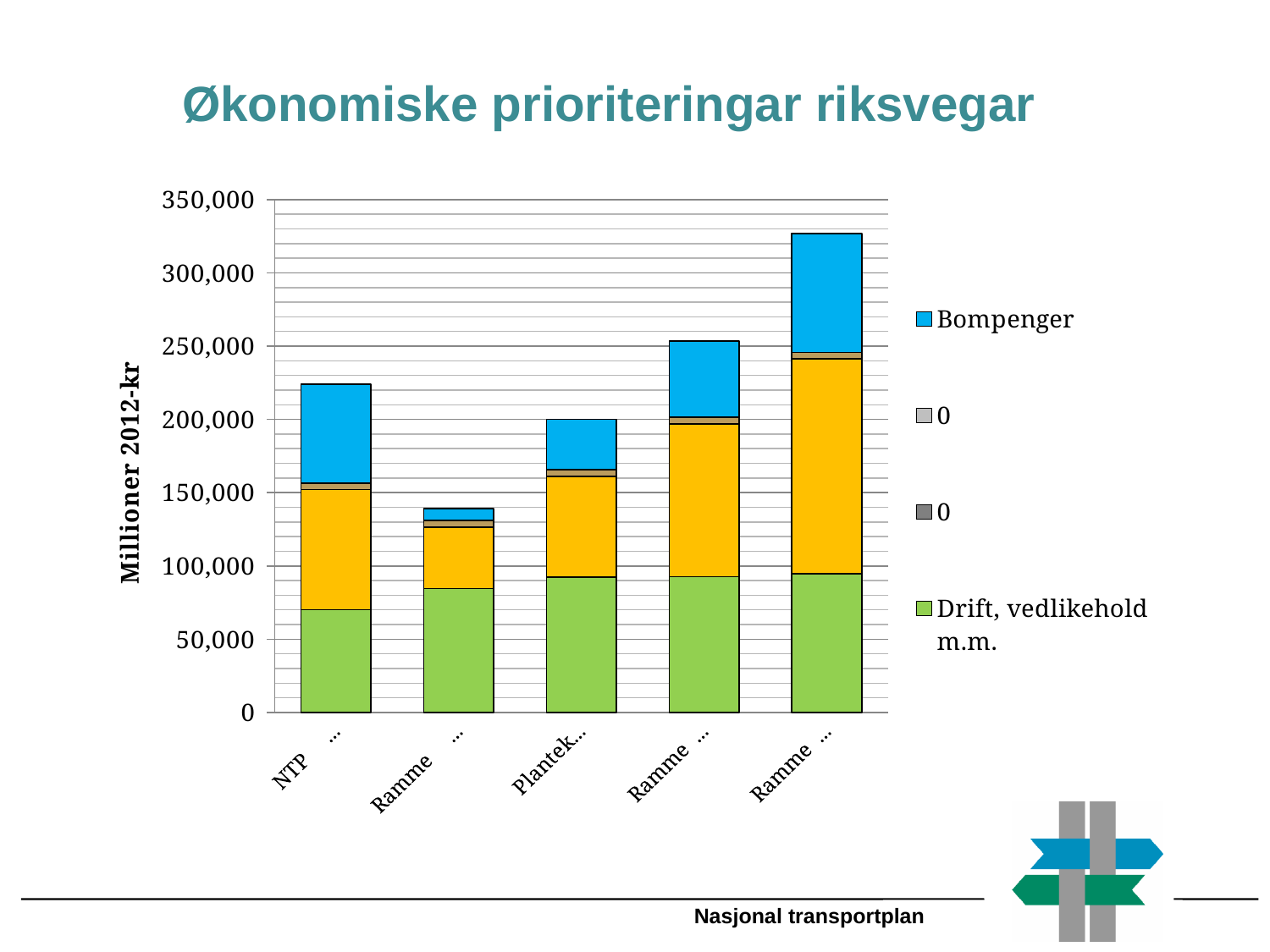
Which has the larger total, the third bar or the fourth bar from the left? The fourth bar Which bar has the lowest total value? The second bar from the left Is the total of the first (leftmost) bar greater or less than 200,000? greater Is the total of the second bar from the left greater or less than 150,000? less Which legend entry is shown in blue? Bompenger Is the total of the rightmost bar greater or less than 300,000? greater What is the label on the vertical axis? Millioner 2012-kr Which bar has the highest total value? The fifth (rightmost) bar How many series does the legend list? 4 What kind of chart is shown on the slide? Stacked bar chart How many bars are plotted in the chart? 5